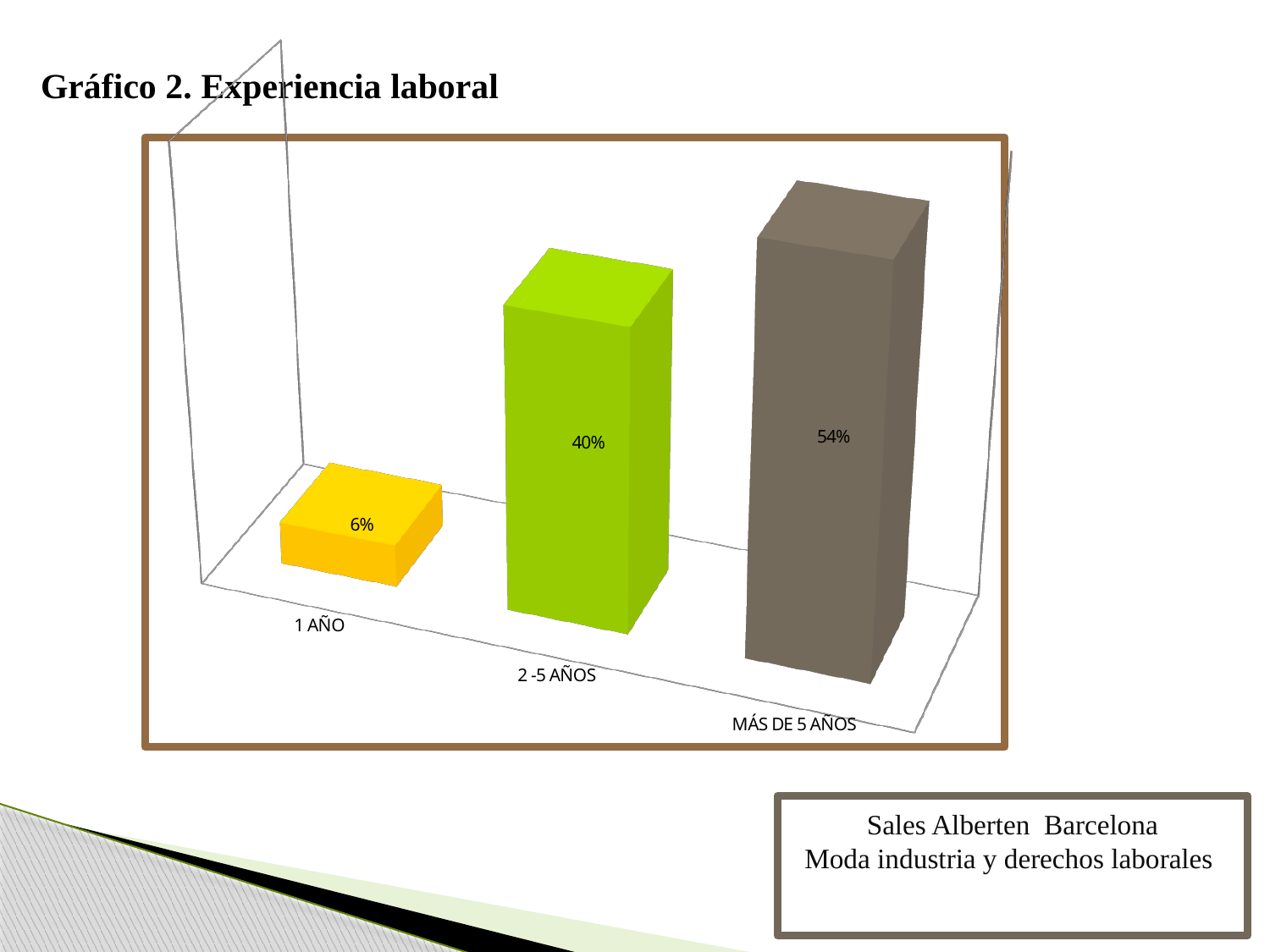
Do the values rise or fall from left to right across the categories? rise How many categories are shown in the chart? 3 What is the title of the chart? Gráfico 2. Experiencia laboral What is the value for MÁS DE 5 AÑOS? 54% What kind of chart is shown on the slide? bar chart What is the difference between the values for 2 -5 AÑOS and 1 AÑO? 34% Which is larger, the value for 2 -5 AÑOS or the value for 1 AÑO? 2 -5 AÑOS Which category has the lowest value? 1 AÑO What is the difference between the values for MÁS DE 5 AÑOS and 2 -5 AÑOS? 14% What is the value for 2 -5 AÑOS? 40% What is the value for 1 AÑO? 6% Which category has the highest value? MÁS DE 5 AÑOS